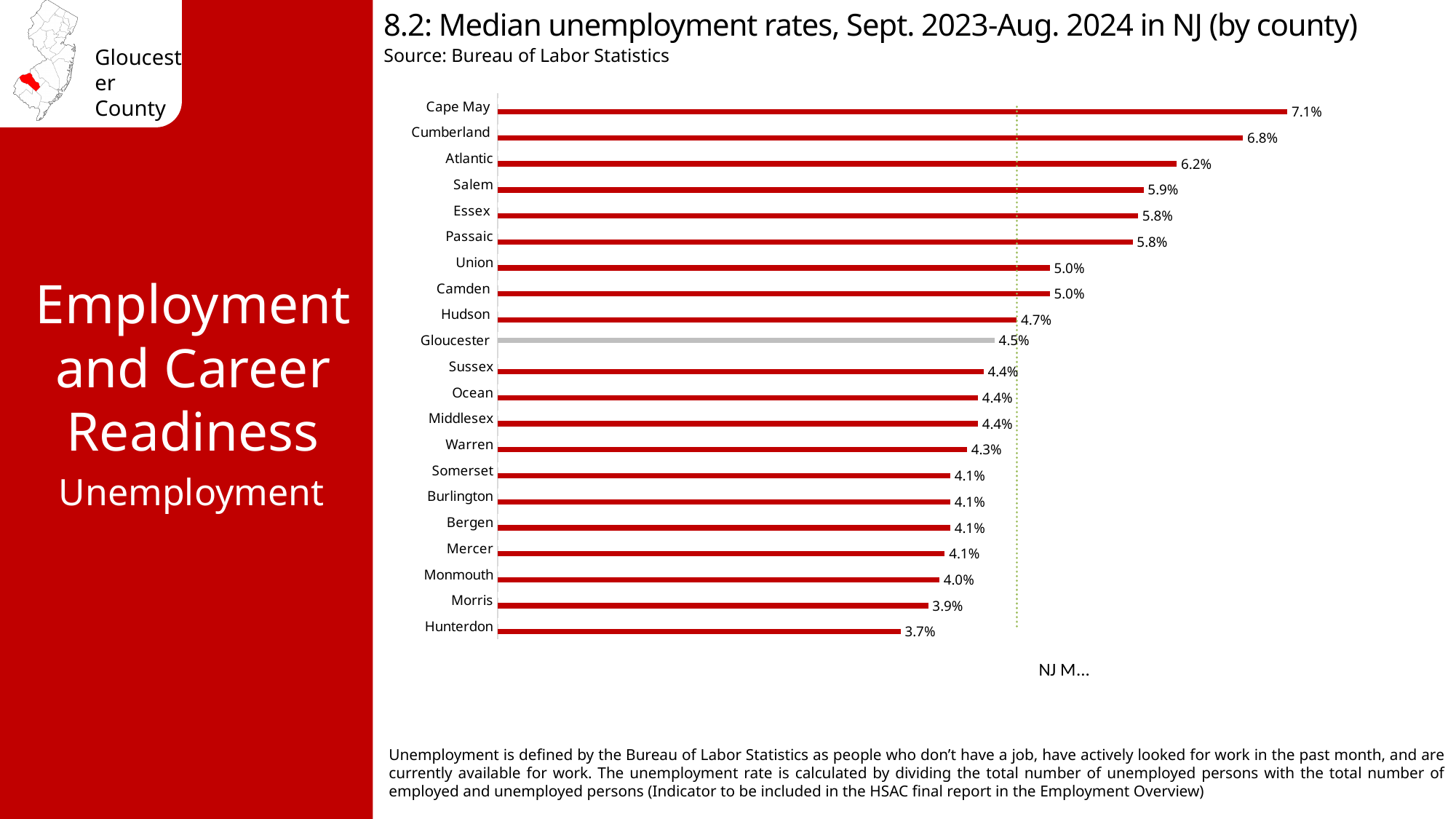
Which county has the lowest median unemployment rate? Hunterdon Which county's bar is shown in grey instead of red? Gloucester What is the median unemployment rate for Cape May? 7.1% Which county has a higher median unemployment rate, Atlantic or Salem? Atlantic What is the median unemployment rate for Gloucester County? 4.5% What is the median unemployment rate for Hunterdon? 3.7% What type of chart is used on this slide? Bar chart How many counties are shown in the chart? 21 What is the difference between the median unemployment rates of Cumberland and Gloucester? 2.3% What is the difference between the median unemployment rates of Cape May and Hunterdon? 3.4% Which county has the highest median unemployment rate? Cape May Which county has a higher median unemployment rate, Gloucester or Morris? Gloucester